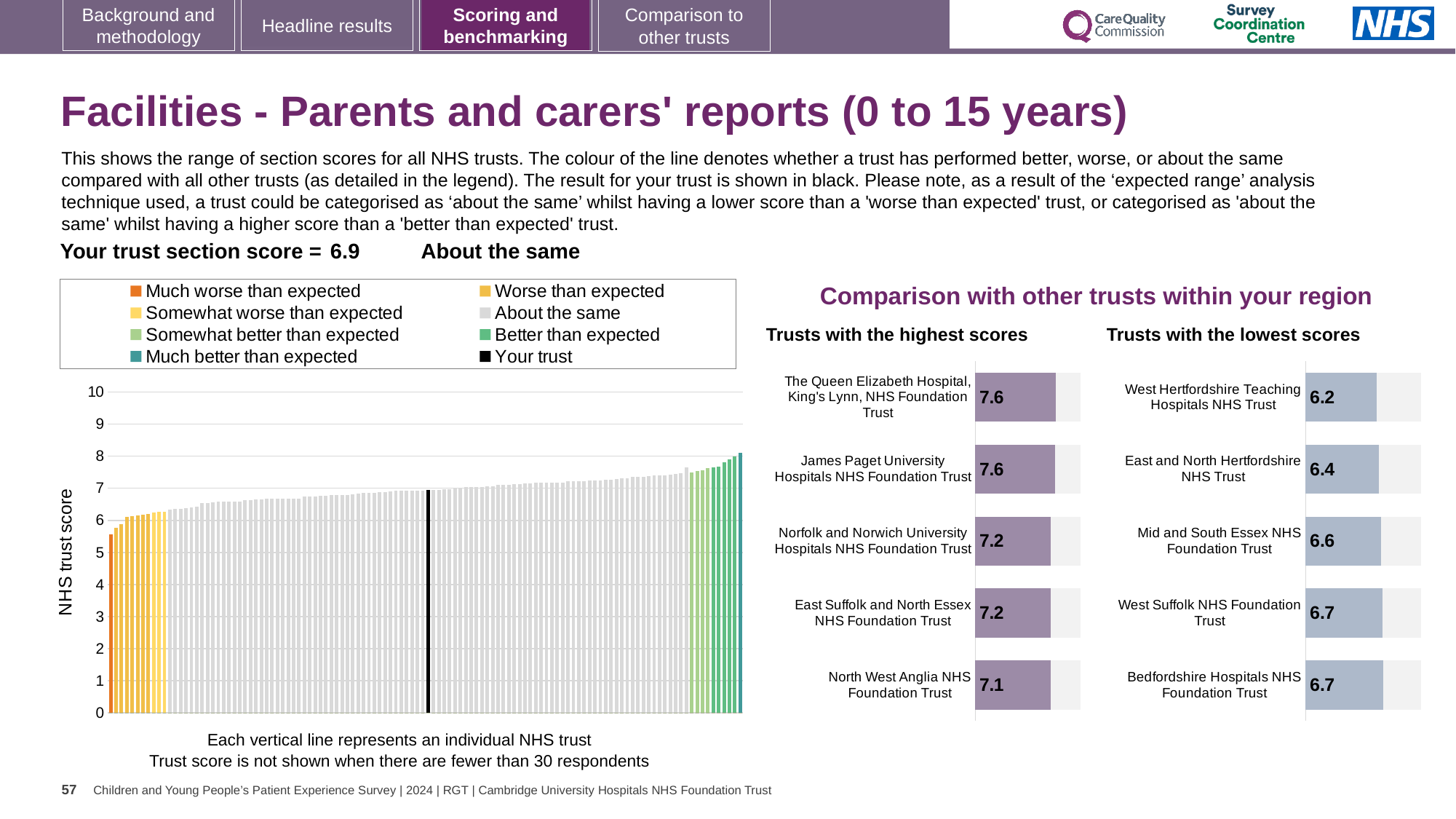
What kind of chart is the main chart on the left showing the NHS trust score for all trusts? Bar chart In the 'Trusts with the lowest scores' chart, which has the higher score: Mid and South Essex NHS Foundation Trust or East and North Hertfordshire NHS Trust? Mid and South Essex NHS Foundation Trust In the 'Trusts with the lowest scores' chart, which trust has the lowest score? West Hertfordshire Teaching Hospitals NHS Trust How many entries does the legend of the main 'NHS trust score' chart list? 8 In the 'Trusts with the highest scores' chart, what is the difference between the score for The Queen Elizabeth Hospital, King's Lynn, NHS Foundation Trust and the score for North West Anglia NHS Foundation Trust? 0.5 In the 'Trusts with the highest scores' chart, what is the score for North West Anglia NHS Foundation Trust? 7.1 What is the label on the vertical axis of the main chart on the left? NHS trust score In the 'Trusts with the lowest scores' chart, what is the score for West Hertfordshire Teaching Hospitals NHS Trust? 6.2 How many trusts are listed in the 'Trusts with the highest scores' chart? 5 In the 'Trusts with the highest scores' chart, what is the score for The Queen Elizabeth Hospital, King's Lynn, NHS Foundation Trust? 7.6 In the 'Trusts with the lowest scores' chart, what is the difference between the score for Bedfordshire Hospitals NHS Foundation Trust and the score for West Hertfordshire Teaching Hospitals NHS Trust? 0.5 In the main 'NHS trust score' chart, is the value for 'Your trust' greater or less than 5? greater